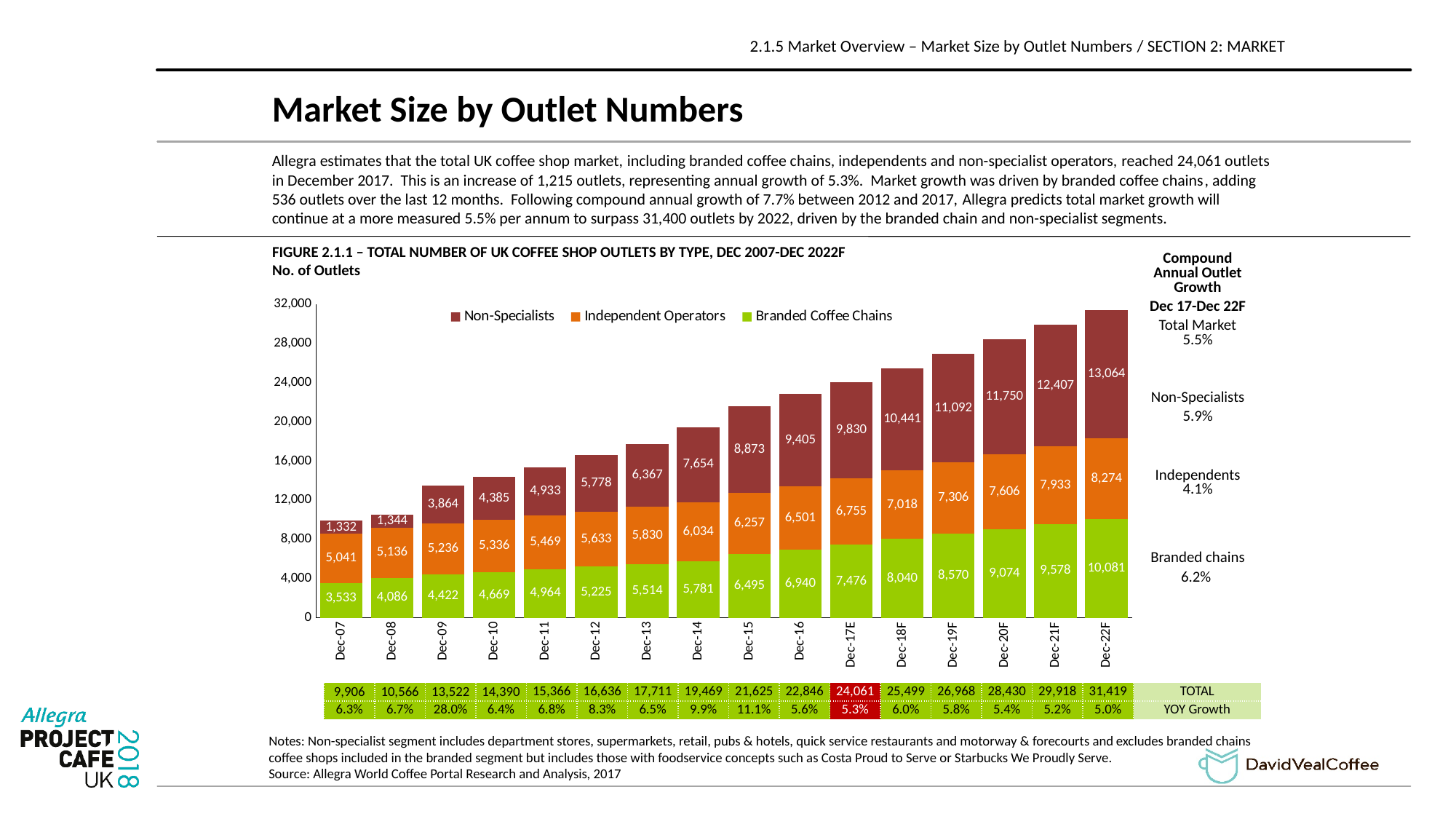
What is the value for Independent Operators in Dec-22F? 8,274 How many series does the legend list? 3 What kind of chart is shown? Stacked bar chart What is the value for Non-Specialists in Dec-14? 7,654 Which year has the highest Branded Coffee Chains value? Dec-22F Which year has the lowest Non-Specialists value? Dec-07 What is the value for Branded Coffee Chains in Dec-17E? 7,476 How many years (bars) are shown on the x axis? 16 Which is larger in Dec-12: Non-Specialists or Branded Coffee Chains? Non-Specialists What is the difference between the Independent Operators values in Dec-22F and Dec-07? 3,233 What is the total of the stacked bar for Dec-17E? 24,061 Do the total outlet numbers rise or fall from Dec-07 to Dec-22F? Rise